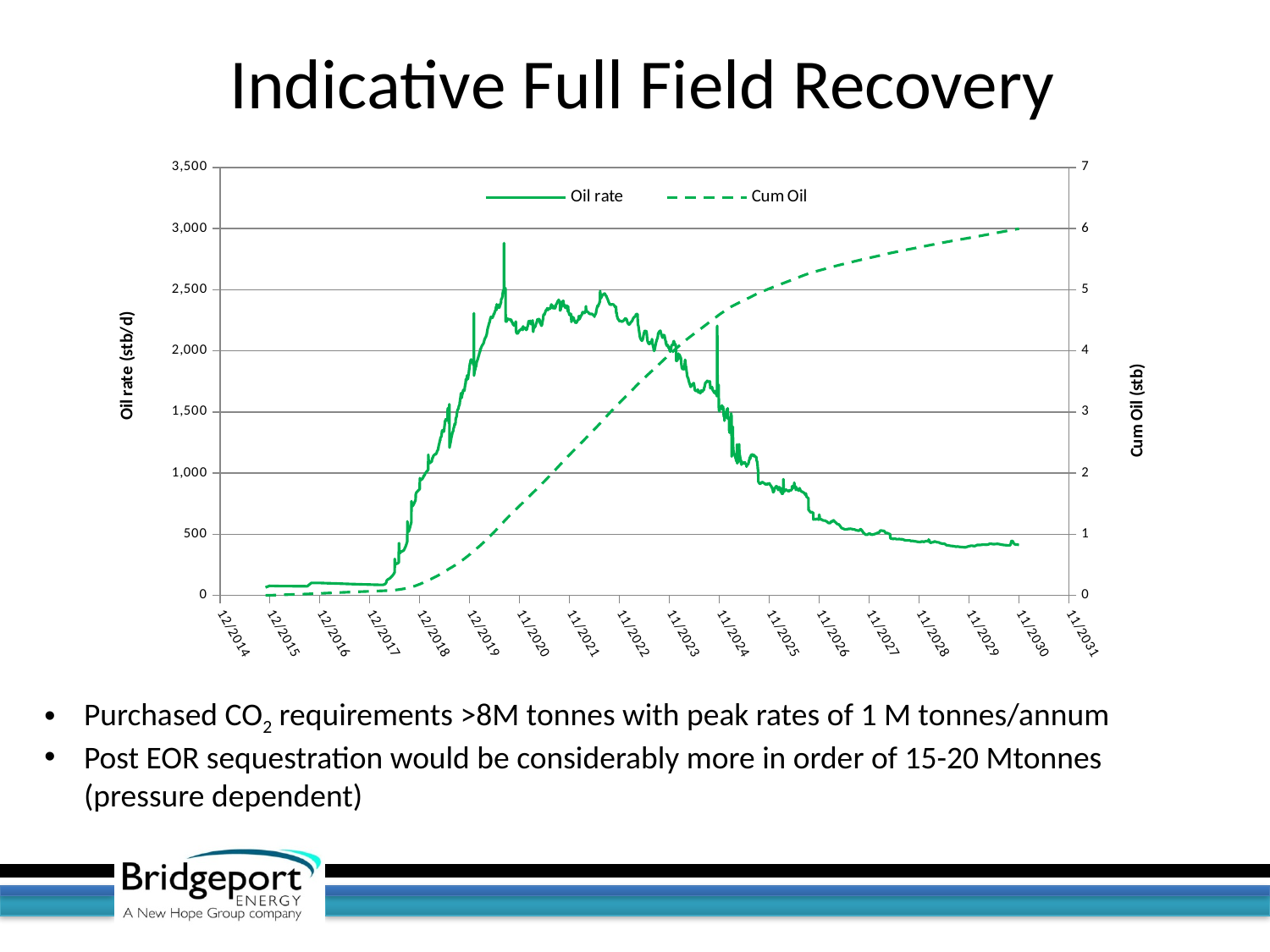
How many series does the chart legend list? 2 Is the Oil rate value at 12/2015 greater or less than 500? less Does the Oil rate series rise or fall between 11/2021 and 11/2029? falls Is the Oil rate value at 11/2028 greater or less than 1,000? less What are the two series named in the chart legend? Oil rate and Cum Oil What is the title of the chart on the slide? Indicative Full Field Recovery Is the Cum Oil value at 11/2029 greater or less than 5? greater Does the Cum Oil series rise or fall along the x axis? rises Which is larger, the Oil rate at 11/2021 or the Oil rate at 11/2027? 11/2021 What kind of chart is shown on the slide? line chart